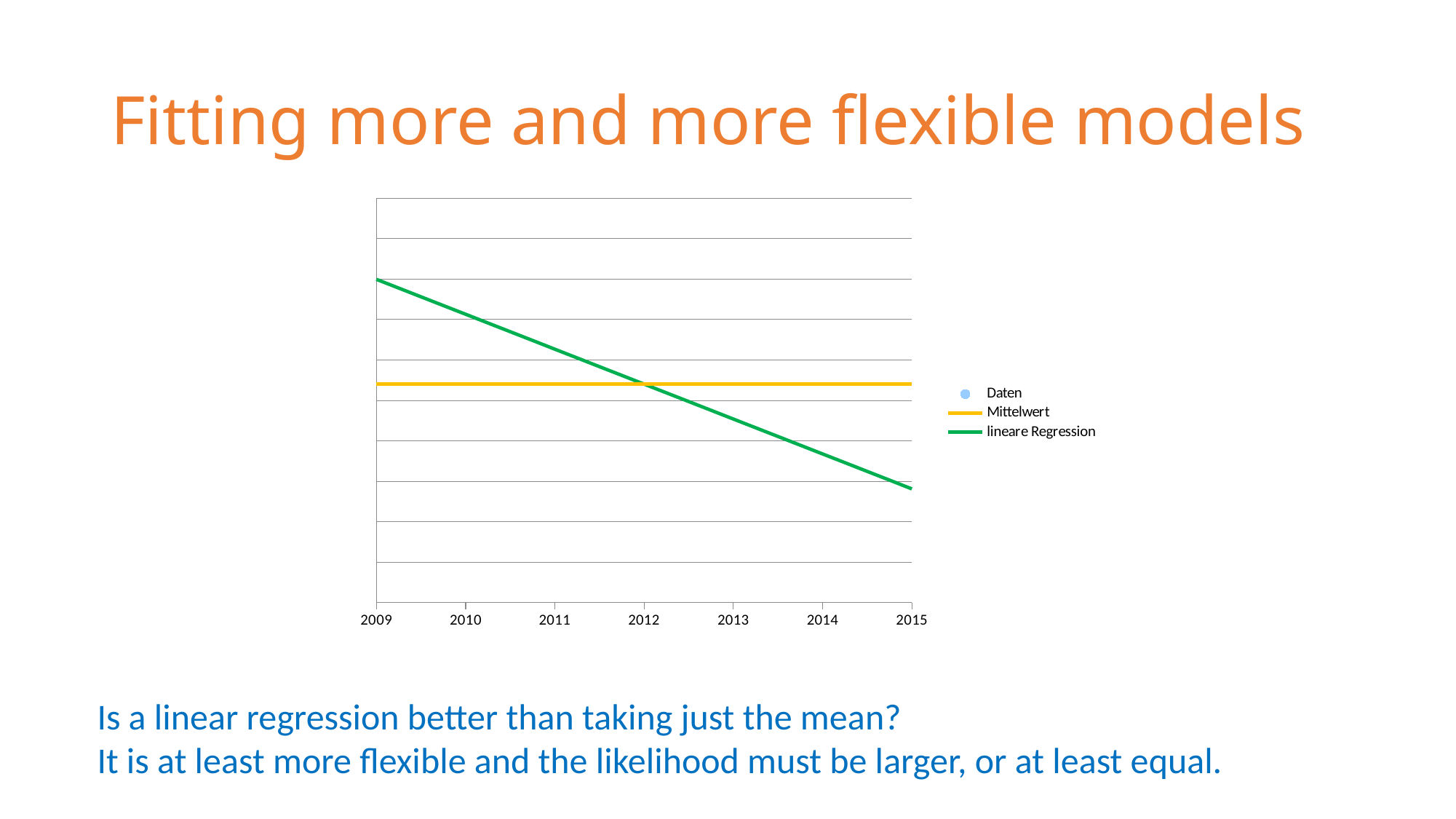
In 2009, which is higher: the 'lineare Regression' line or the 'Mittelwert' line? lineare Regression How many series does the legend list? 3 Which series is drawn in green? lineare Regression Does the 'Mittelwert' line rise, fall or stay constant across the years? stay constant In 2010, is the 'lineare Regression' line above or below the 'Mittelwert' line? above Does the 'lineare Regression' line rise or fall from 2009 to 2015? fall In 2014, is the 'lineare Regression' line above or below the 'Mittelwert' line? below What is the first year shown on the x axis? 2009 What kind of chart is shown on the slide? line chart What is the last year shown on the x axis? 2015 How many years are labelled on the x axis? 7